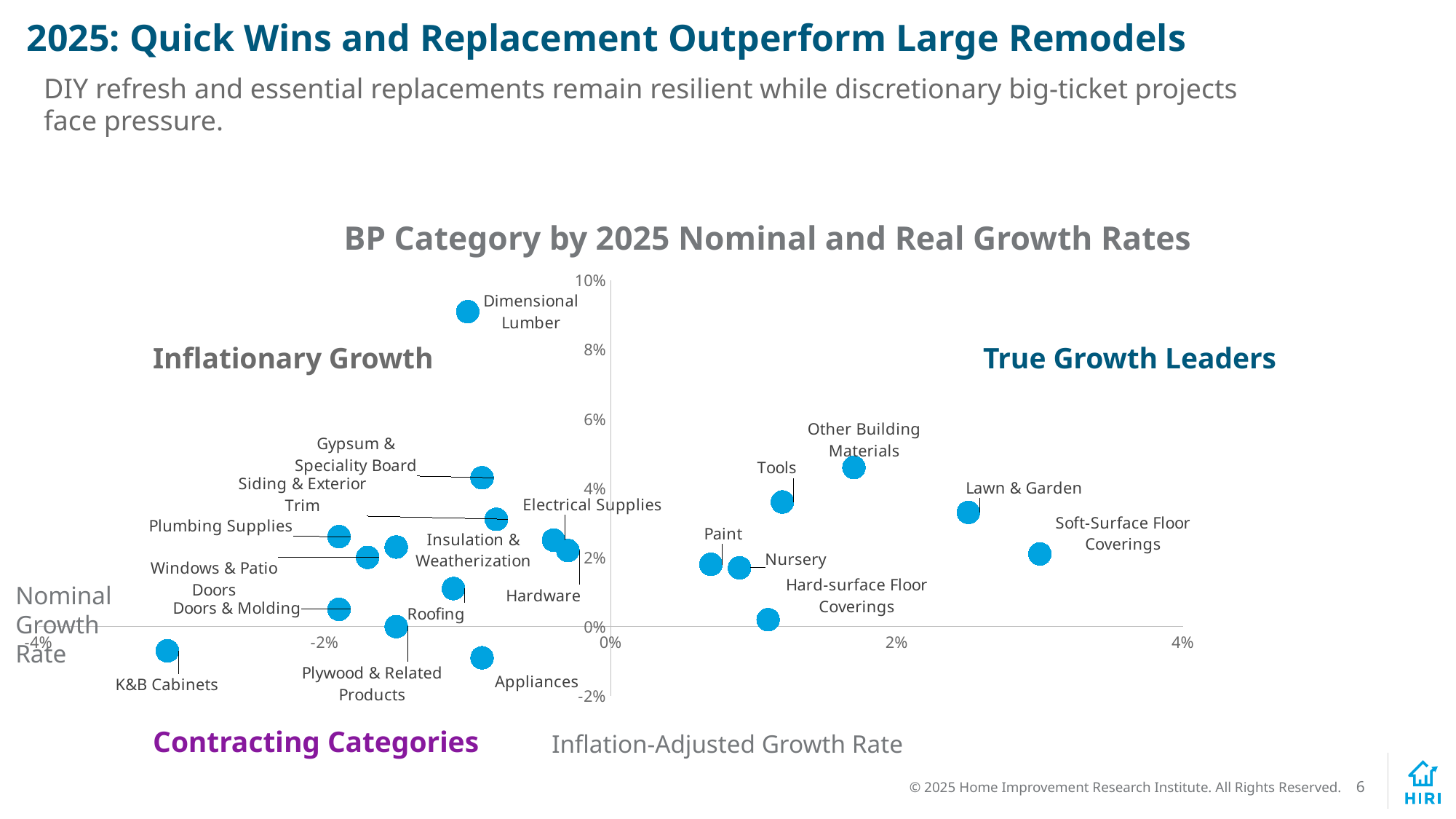
Is the nominal growth rate for Hard-surface Floor Coverings greater or less than 2%? less Which quadrant label appears in the upper right of the chart? True Growth Leaders Which category has the lowest inflation-adjusted growth rate? K&B Cabinets What is the title of the chart? BP Category by 2025 Nominal and Real Growth Rates Which category has the highest inflation-adjusted growth rate? Soft-Surface Floor Coverings Is the nominal growth rate for Dimensional Lumber greater or less than 8%? greater Is the inflation-adjusted growth rate for Lawn & Garden greater or less than 2%? greater Which has the higher nominal growth rate, Dimensional Lumber or Tools? Dimensional Lumber Which category has the highest nominal growth rate? Dimensional Lumber What kind of chart is shown on the slide? Scatter chart